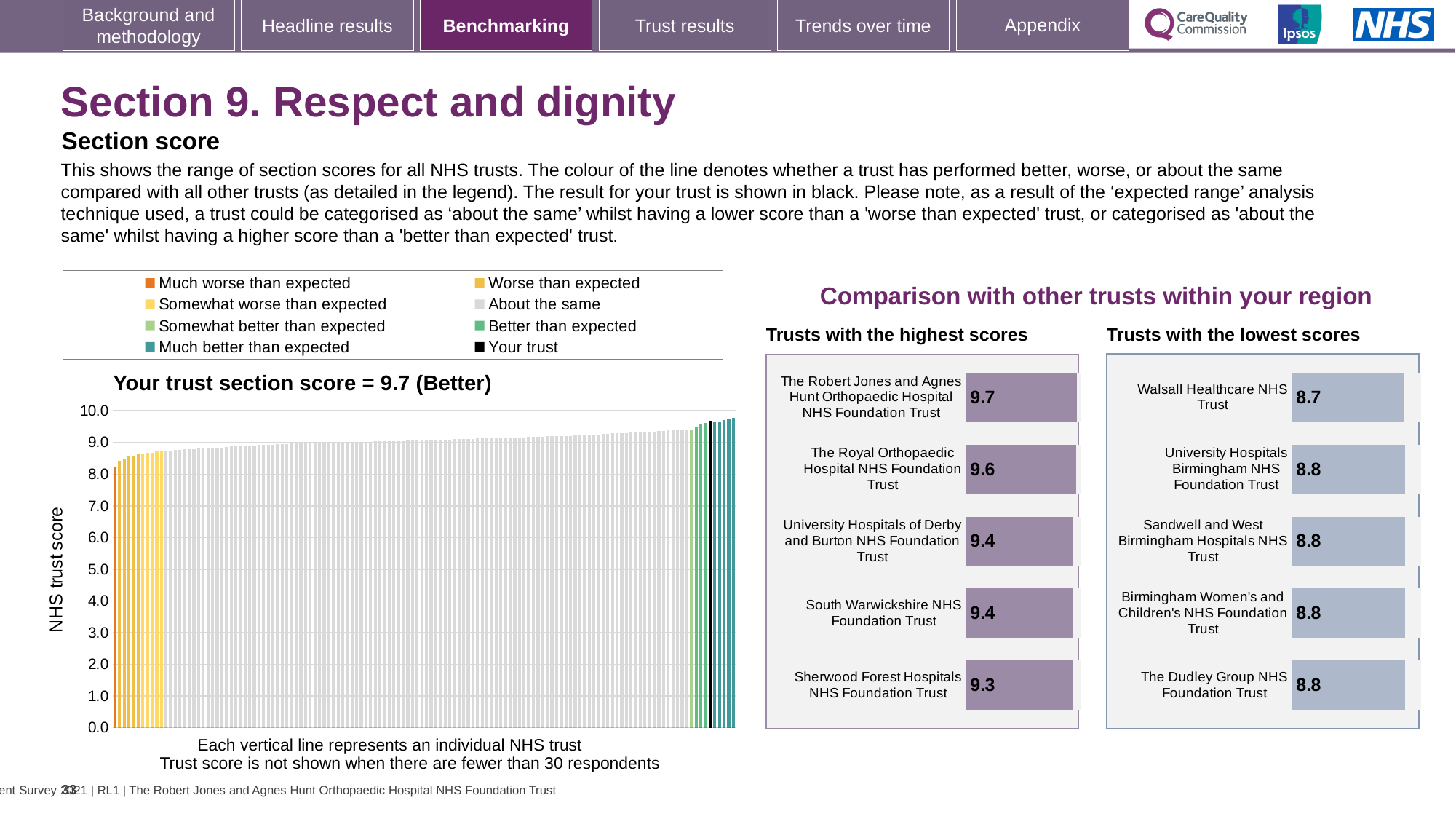
In the 'Trusts with the highest scores' chart, which has the larger score: The Royal Orthopaedic Hospital NHS Foundation Trust or Sherwood Forest Hospitals NHS Foundation Trust? The Royal Orthopaedic Hospital NHS Foundation Trust In the 'Trusts with the lowest scores' chart, what is the score for The Dudley Group NHS Foundation Trust? 8.8 In the 'Trusts with the highest scores' chart, what is the difference between the scores of The Robert Jones and Agnes Hunt Orthopaedic Hospital NHS Foundation Trust and Sherwood Forest Hospitals NHS Foundation Trust? 0.4 In the 'Your trust section score' chart on the left, do the bar values rise or fall from left to right? Rise How many entries does the legend above the 'Your trust section score' chart list? 8 In the 'Your trust section score' chart on the left, is the value for your trust (the black bar) greater or less than 9.0? greater What kind of chart is the 'Your trust section score' chart on the left? Bar chart In the 'Trusts with the lowest scores' chart, which trust has the lowest score? Walsall Healthcare NHS Trust In the 'Trusts with the highest scores' chart, what is the score for The Royal Orthopaedic Hospital NHS Foundation Trust? 9.6 In the 'Trusts with the highest scores' chart, which trust has the highest score? The Robert Jones and Agnes Hunt Orthopaedic Hospital NHS Foundation Trust In the 'Trusts with the highest scores' chart, how many trusts are shown? 5 In the 'Trusts with the lowest scores' chart, what is the score for Walsall Healthcare NHS Trust? 8.7